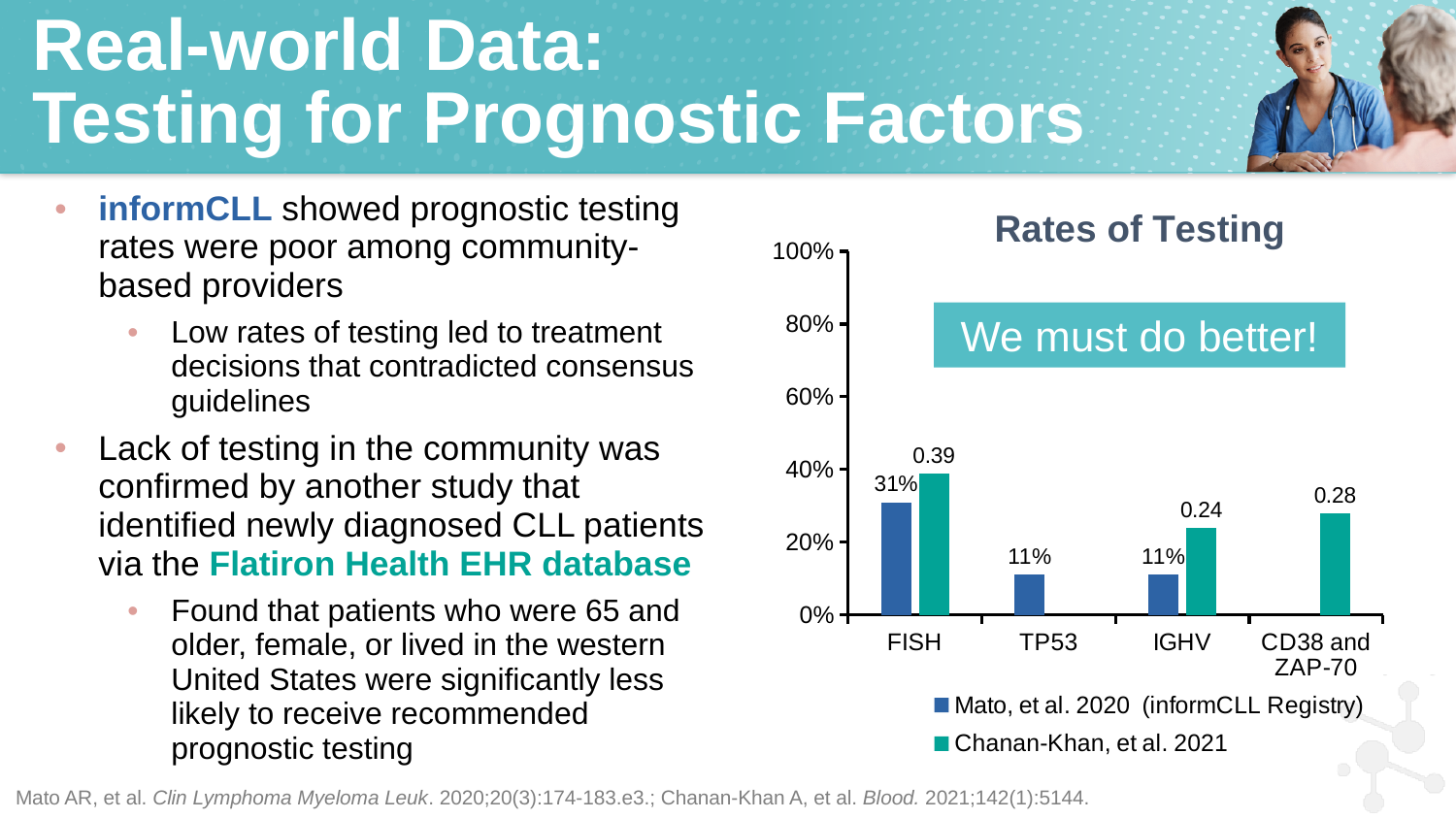
How many series does the chart legend list? 2 Which category has the highest value in the Mato, et al. 2020 (informCLL Registry) series? FISH What is the difference between the FISH and TP53 values in the Mato, et al. 2020 (informCLL Registry) series? 20% Is the value for FISH in the Chanan-Khan, et al. 2021 series greater or less than 20%? greater Which category has the lowest value in the Chanan-Khan, et al. 2021 series? IGHV How many categories are shown on the x axis of the chart? 4 What is the title of the chart? Rates of Testing What is the value for FISH in the Chanan-Khan, et al. 2021 series? 0.39 What type of chart is shown on the slide? bar chart What is the value for CD38 and ZAP-70 in the Chanan-Khan, et al. 2021 series? 0.28 What is the value for IGHV in the Chanan-Khan, et al. 2021 series? 0.24 What is the value for FISH in the Mato, et al. 2020 (informCLL Registry) series? 31%